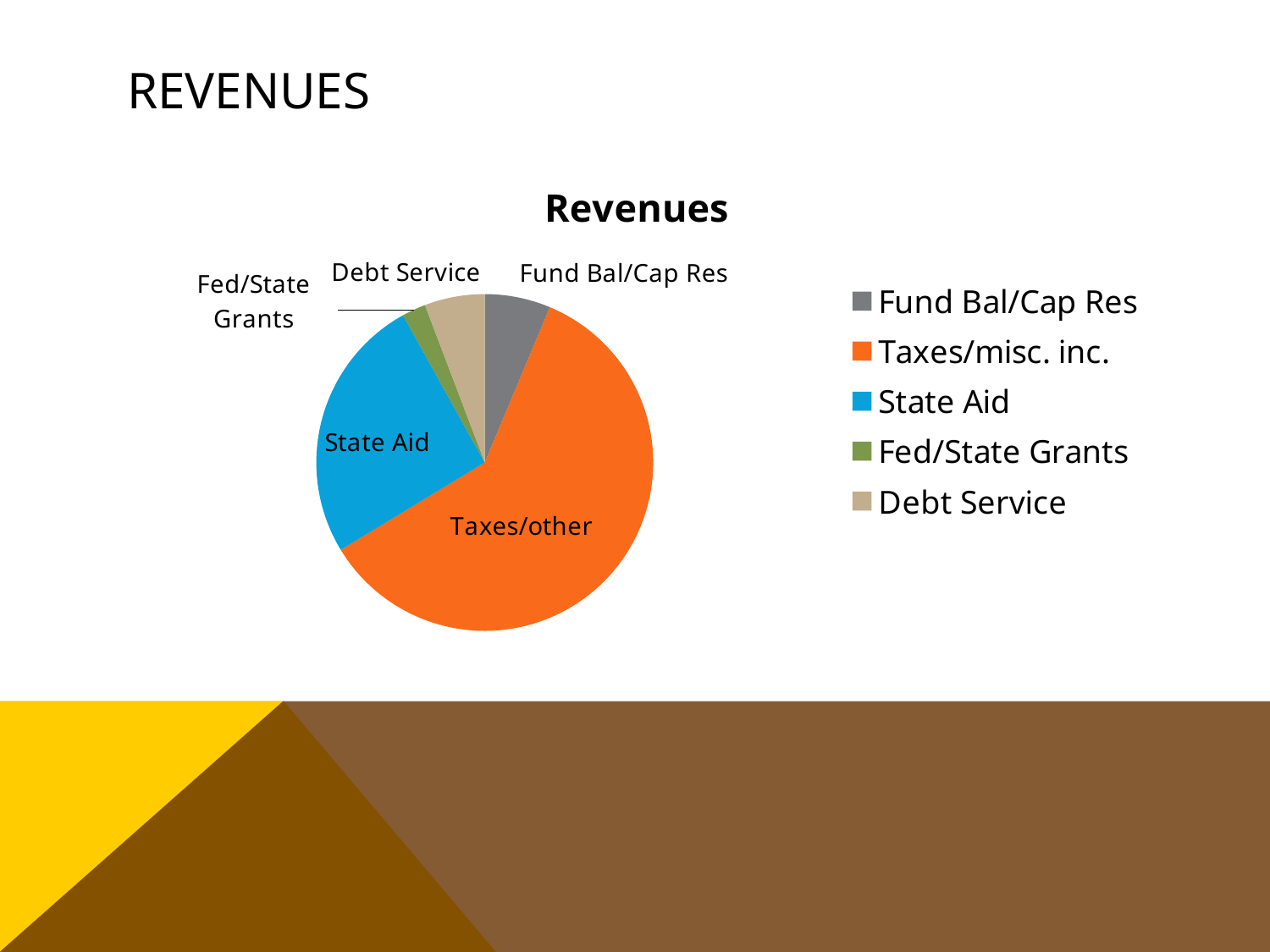
Which is larger, the Taxes/other slice or the State Aid slice? Taxes/other Which is larger, the State Aid slice or the Fund Bal/Cap Res slice? State Aid How many slices does the pie chart have? 5 How many entries does the legend list? 5 Which slice is the second largest in the pie chart? State Aid Which is larger, the Debt Service slice or the Fed/State Grants slice? Debt Service Which slice of the pie chart is the largest? Taxes/other What is the title of the chart? Revenues Which slice of the pie chart is the smallest? Fed/State Grants What kind of chart is shown on the slide? Pie chart Which legend entry is shown in blue? State Aid